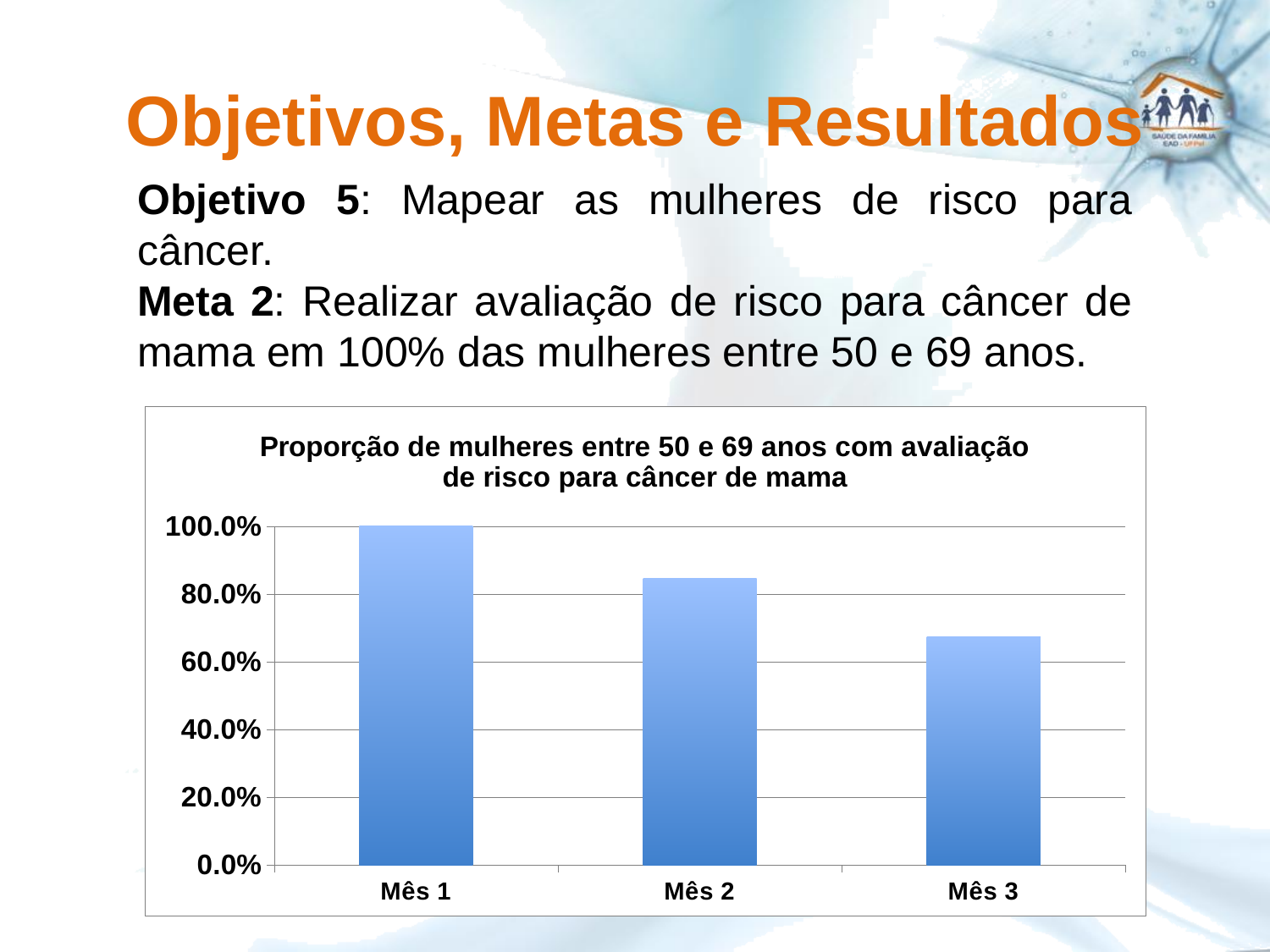
Which month has the highest value? Mês 1 Is the value for Mês 3 greater or less than 60.0%? greater Is the value for Mês 3 greater or less than 80.0%? less Which is larger, the value for Mês 2 or the value for Mês 3? Mês 2 How many bars (categories) does the chart show? 3 Do the values rise or fall from Mês 1 to Mês 3? fall What is the title of the chart? Proporção de mulheres entre 50 e 69 anos com avaliação de risco para câncer de mama Is the value for Mês 2 greater or less than 80.0%? greater What is the highest value shown on the vertical axis? 100.0% What kind of chart is shown on the slide? bar chart Which month has the lowest value? Mês 3 What is the value for Mês 1? 100.0%